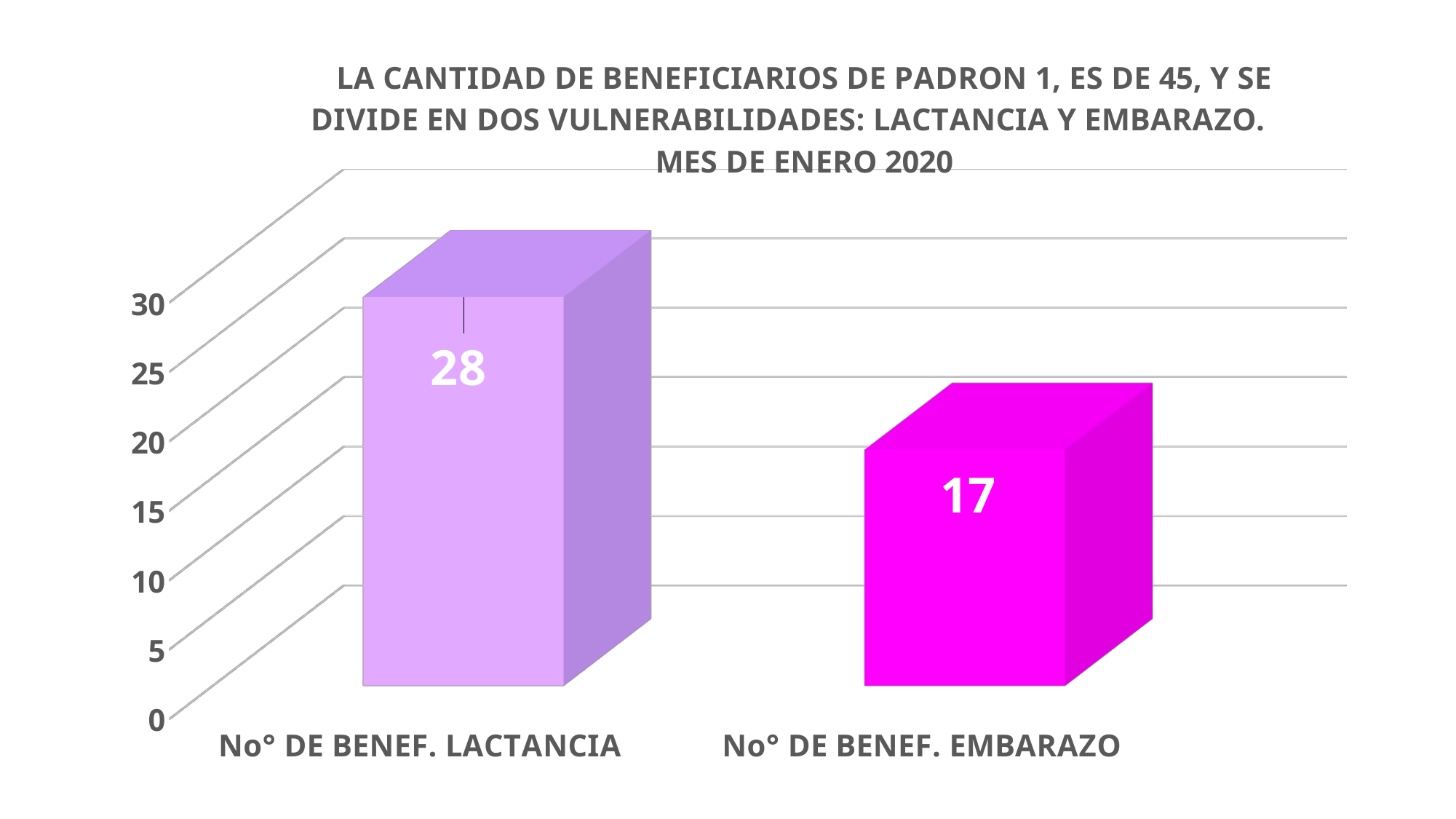
Which category has the highest value? No° DE BENEF. LACTANCIA What month and year does the chart title refer to? ENERO 2020 What is the total of the two values shown in the chart? 45 What is the difference between the values for No° DE BENEF. LACTANCIA and No° DE BENEF. EMBARAZO? 11 How many categories are shown in the chart? 2 Is the value for No° DE BENEF. LACTANCIA greater or less than 25? greater Which category has the lowest value? No° DE BENEF. EMBARAZO Which is larger, the value for No° DE BENEF. LACTANCIA or No° DE BENEF. EMBARAZO? No° DE BENEF. LACTANCIA What is the value for No° DE BENEF. EMBARAZO? 17 What kind of chart is shown on the slide? bar chart What is the value for No° DE BENEF. LACTANCIA? 28 Is the value for No° DE BENEF. EMBARAZO greater or less than 20? less